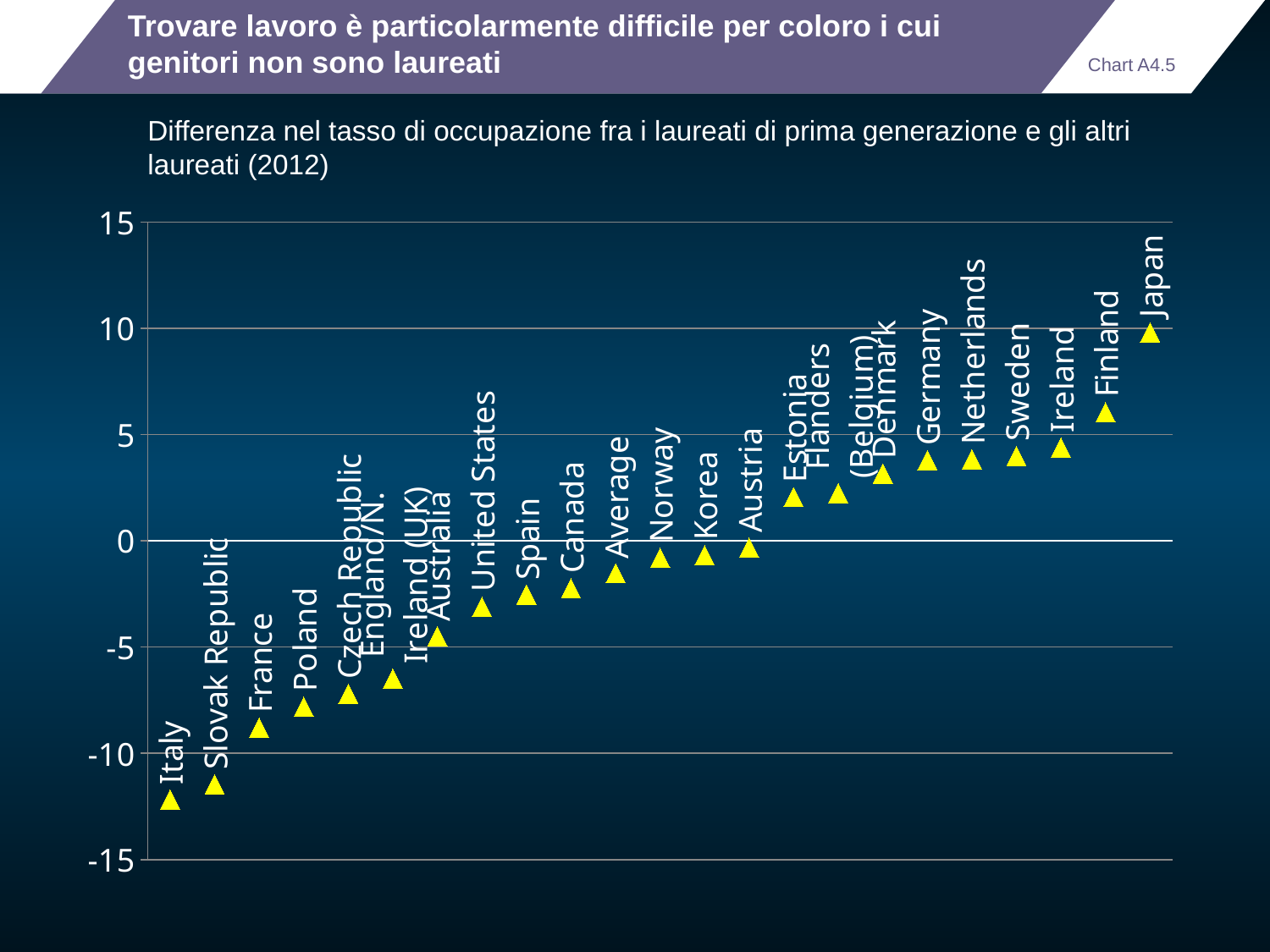
Which country has the lowest value on the chart? Italy What year does the chart subtitle say the data refers to? 2012 Is the value for Germany greater or less than 0? greater Which has the larger value, France or Italy? France Is the value for Australia greater or less than 0? less Is the value for Italy greater or less than -10? less How many countries or regions are plotted on the chart? 22 Which country has the highest value on the chart? Japan Do the values rise or fall moving from left to right along the x axis? rise Which has the larger value, Japan or Finland? Japan